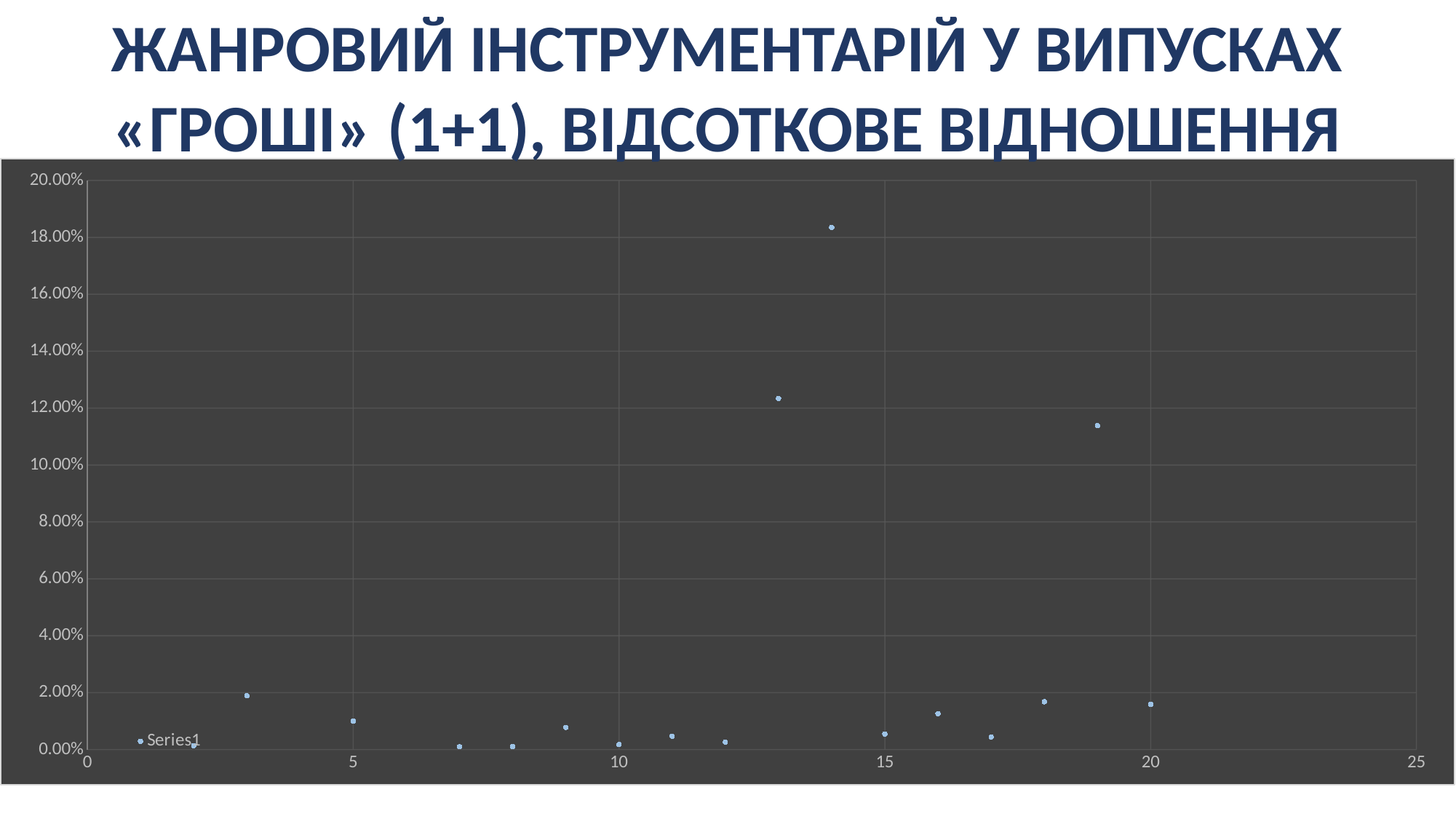
Is the value at x = 14 greater or less than 16.00%? greater Is the value at x = 19 greater or less than 12.00%? less What kind of chart is shown on the slide? scatter chart Is the value at x = 19 greater or less than 10.00%? greater Which has the larger value, the point at x = 3 or the point at x = 5? x = 3 What is the name of the data series labelled on the chart? Series1 At which x value does the chart reach its highest point? 14 What is the highest value shown on the vertical axis? 20.00% Which has the larger value, the point at x = 13 or the point at x = 19? x = 13 Which has the larger value, the point at x = 14 or the point at x = 13? x = 14